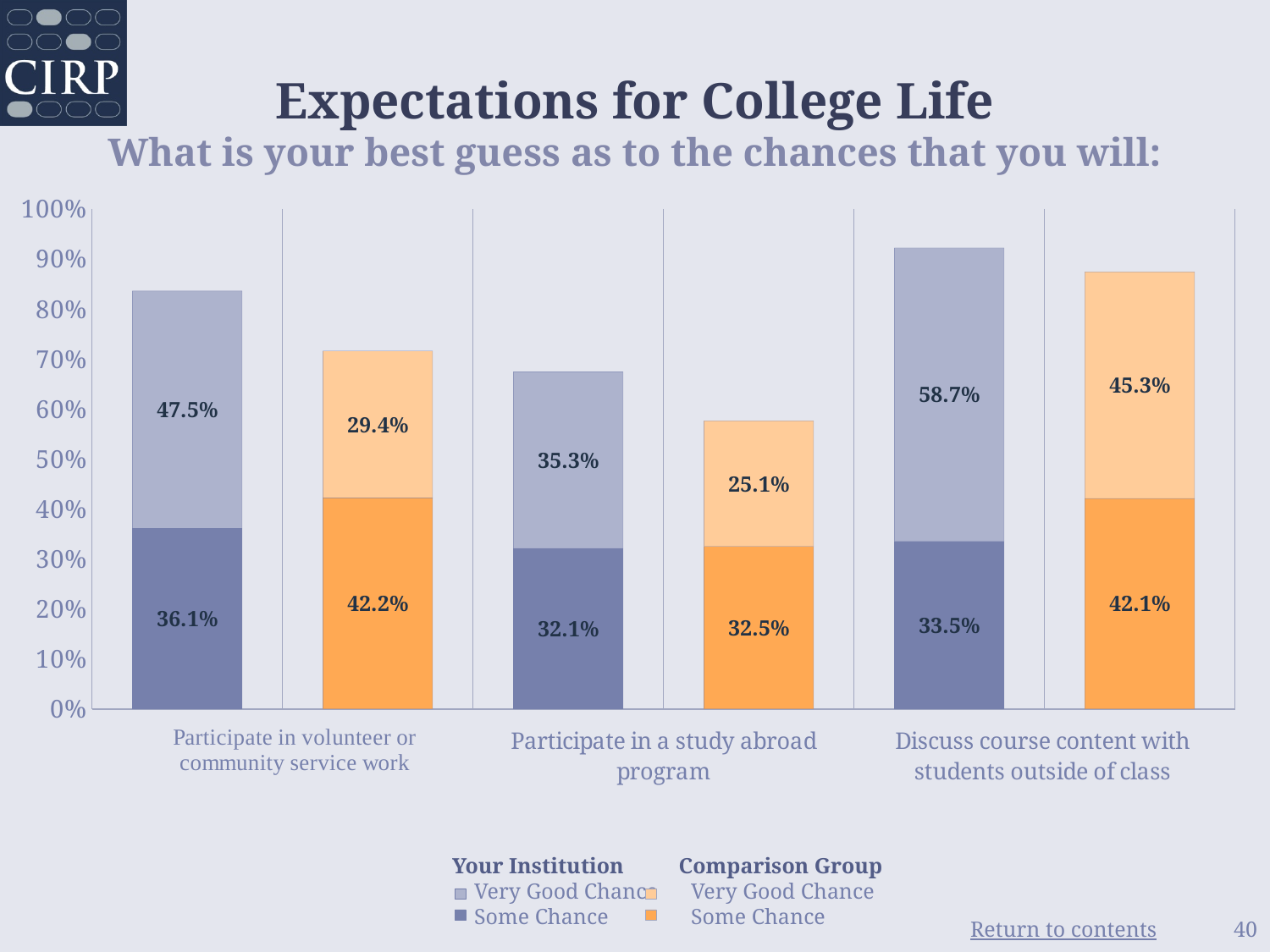
Which category has the highest 'Very Good Chance' value for Your Institution? Discuss course content with students outside of class Which category has the lowest 'Very Good Chance' value for the Comparison Group? Participate in a study abroad program What is the total of the stacked bar for the Comparison Group for 'Participate in a study abroad program'? 57.6% What is the 'Some Chance' value for the Comparison Group for 'Participate in a study abroad program'? 32.5% What is the total of the stacked bar for Your Institution for 'Discuss course content with students outside of class'? 92.2% How many categories are shown on the x axis? 3 What is the 'Very Good Chance' value for Your Institution for 'Participate in volunteer or community service work'? 47.5% For 'Discuss course content with students outside of class', which is larger: Your Institution's 'Very Good Chance' value or the Comparison Group's 'Very Good Chance' value? Your Institution What is the 'Very Good Chance' value for the Comparison Group for 'Discuss course content with students outside of class'? 45.3% What is the difference between Your Institution's and the Comparison Group's 'Very Good Chance' values for 'Participate in volunteer or community service work'? 18.1% How many series does the legend list? 4 What kind of chart is shown on the slide? Stacked bar chart